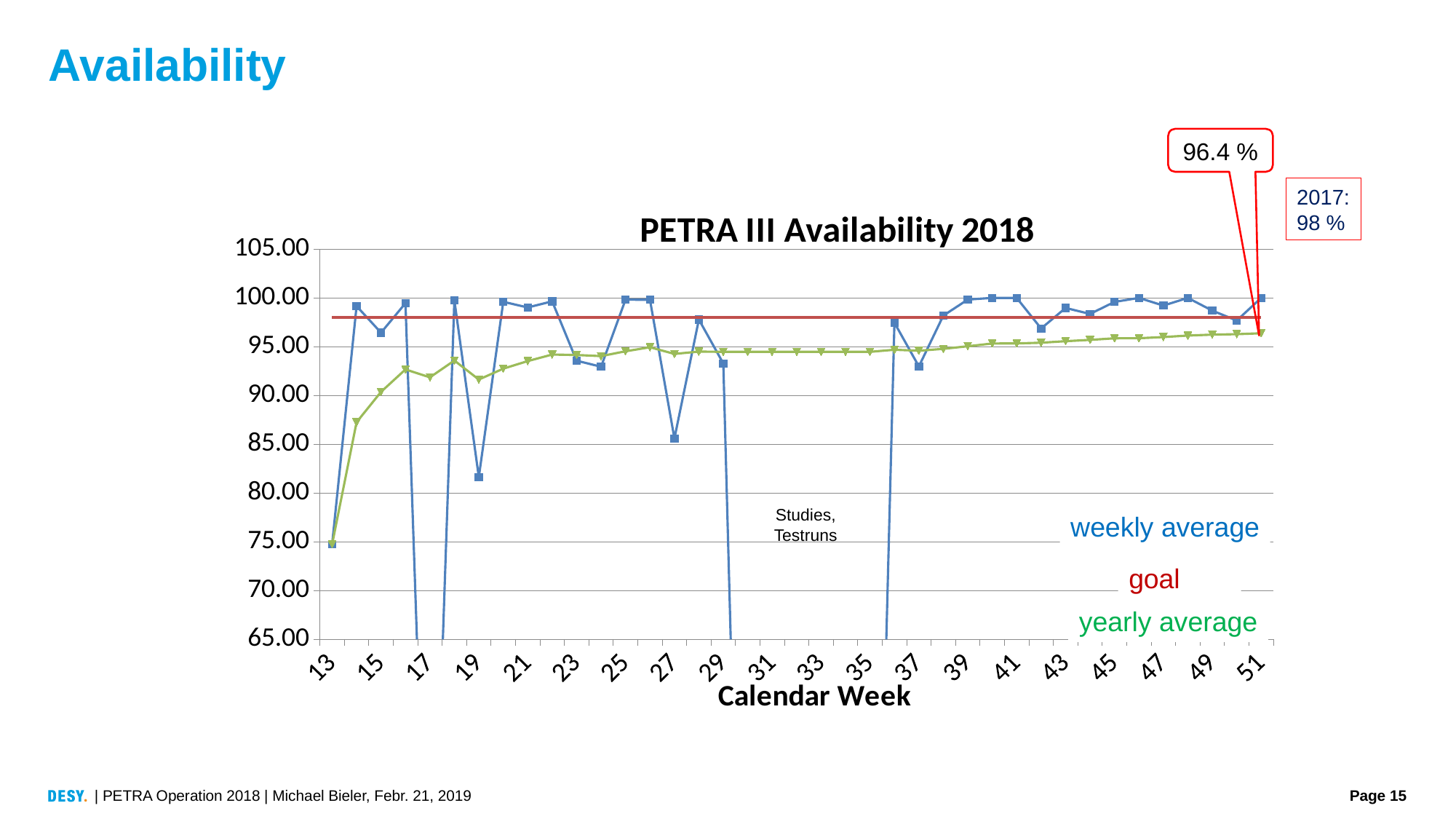
What is the title of the chart? PETRA III Availability 2018 What availability value is given for 2017 on the slide? 98 % Is the weekly average for calendar week 40 greater or less than 95? greater Which is larger, the weekly average for week 19 or for week 21? week 21 What kind of chart is shown on the slide? line chart Is the weekly average for calendar week 19 greater or less than 85? less What value does the callout give for the yearly average at the end of 2018 (week 51)? 96.4 % Does the yearly average line rise or fall from week 13 to week 51? rise Is the weekly average for calendar week 13 greater or less than 80? less What is the x-axis title of the chart? Calendar Week How many series are labelled on the chart? 3